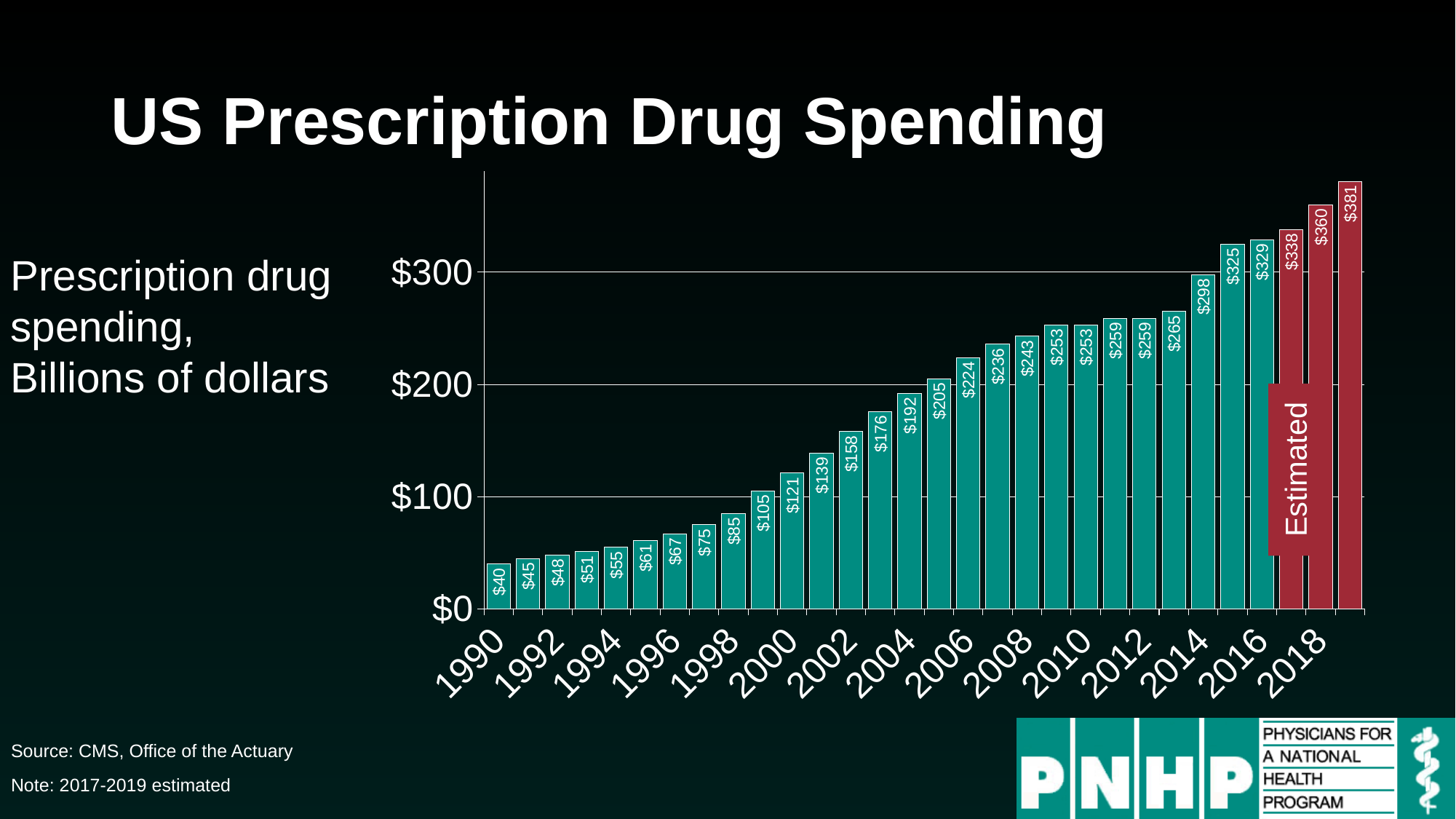
What was US prescription drug spending in 2000? $121 What was US prescription drug spending in 1990? $40 Which year had higher spending, 2004 or 2006? 2006 What was US prescription drug spending in 2016? $329 Is the value for 2014 greater or less than $200? greater What label is printed on the red bars at the right of the chart? Estimated Which year has the lowest prescription drug spending? 1990 What type of chart is shown on the slide? bar chart What is the value of the highest bar in the chart? $381 What is the difference in spending between 2018 and 2008? $117 What was US prescription drug spending in 2010? $253 Do the values generally rise or fall from 1990 to the last bar? rise